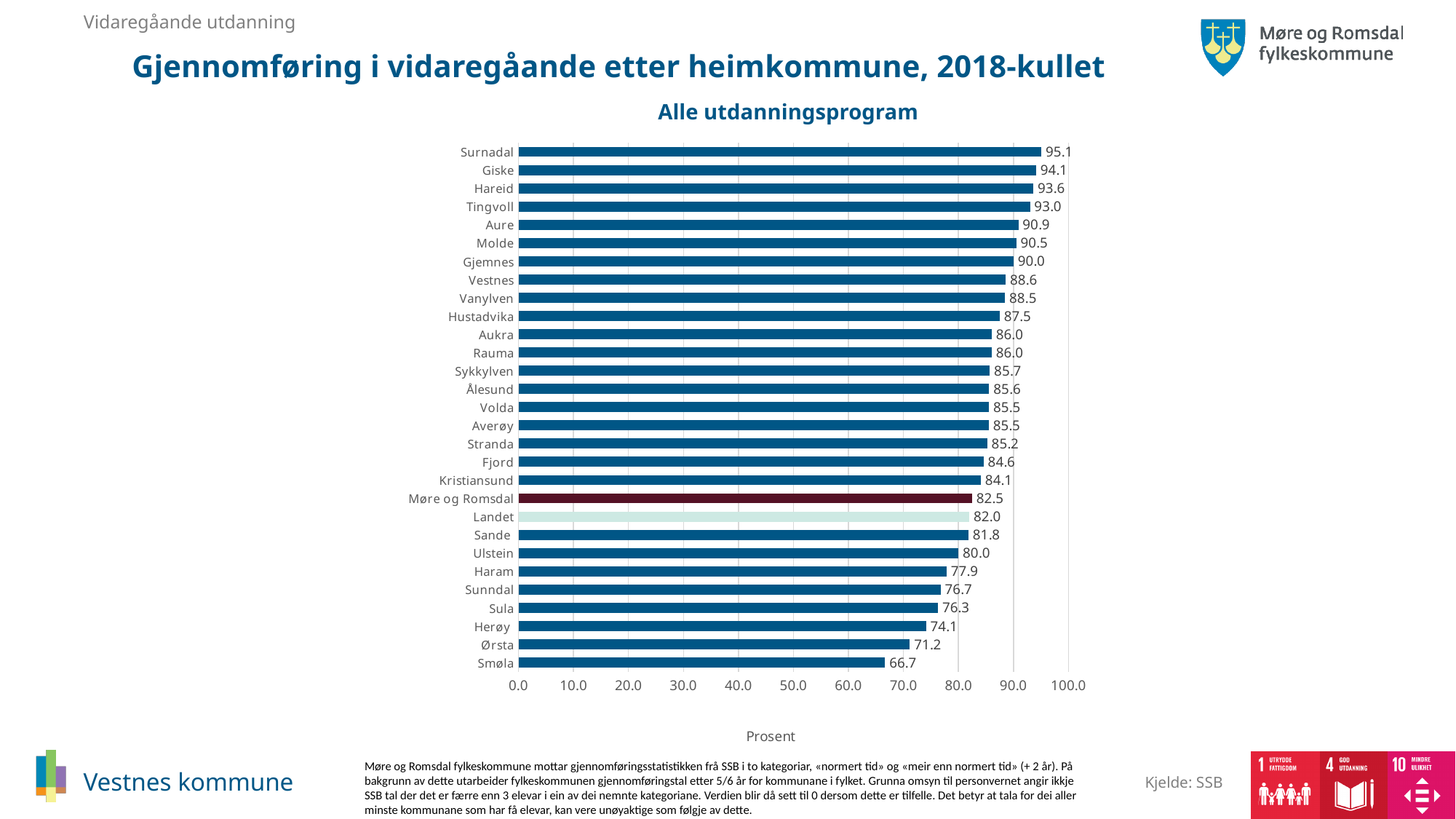
What is the difference between the values for Surnadal and Smøla? 28.4 What kind of chart is shown on the slide? bar chart Which category has the highest value? Surnadal What is the value for Vestnes? 88.6 Is the value for Ørsta greater or less than 80.0? less Which category has the lowest value? Smøla What is the title of the chart? Alle utdanningsprogram What is the value for Landet? 82.0 Which is larger, the value for Molde or the value for Ålesund? Molde How many categories are shown on the chart? 29 What is the value for Møre og Romsdal? 82.5 What is the difference between the values for Vestnes and Landet? 6.6